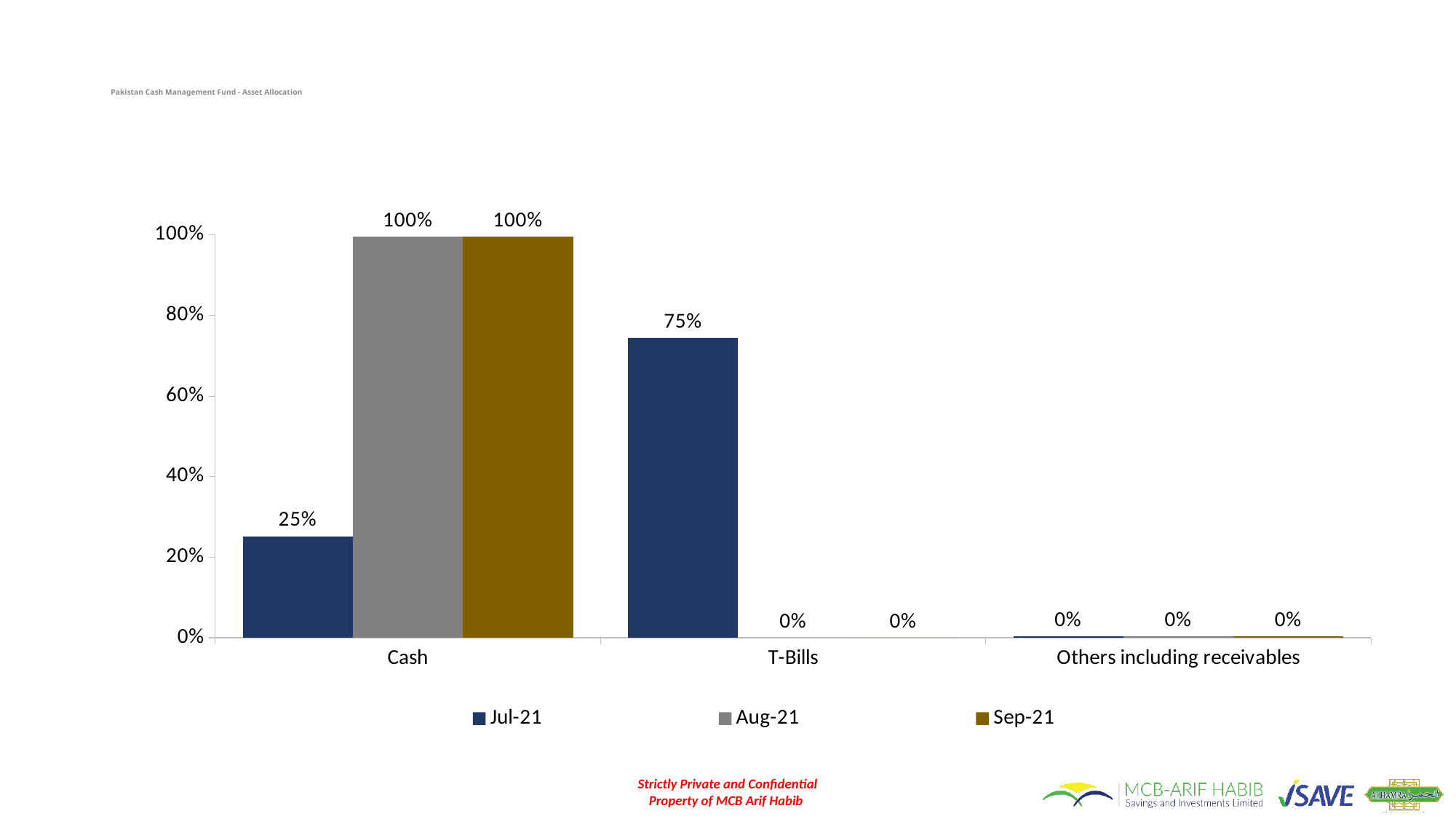
How many series does the legend list? 3 What is the difference between the Jul-21 values for T-Bills and Cash? 50% Which series is shown in grey in the legend? Aug-21 What is the Sep-21 value for T-Bills? 0% What kind of chart is shown on the slide? Bar chart What is the Jul-21 value for Cash? 25% What is the Jul-21 value for T-Bills? 75% Which category has the highest Jul-21 value? T-Bills What is the Aug-21 value for Cash? 100% How many categories are shown on the x axis? 3 Which is larger for Cash: the Jul-21 value or the Sep-21 value? Sep-21 What is the Sep-21 value for Others including receivables? 0%